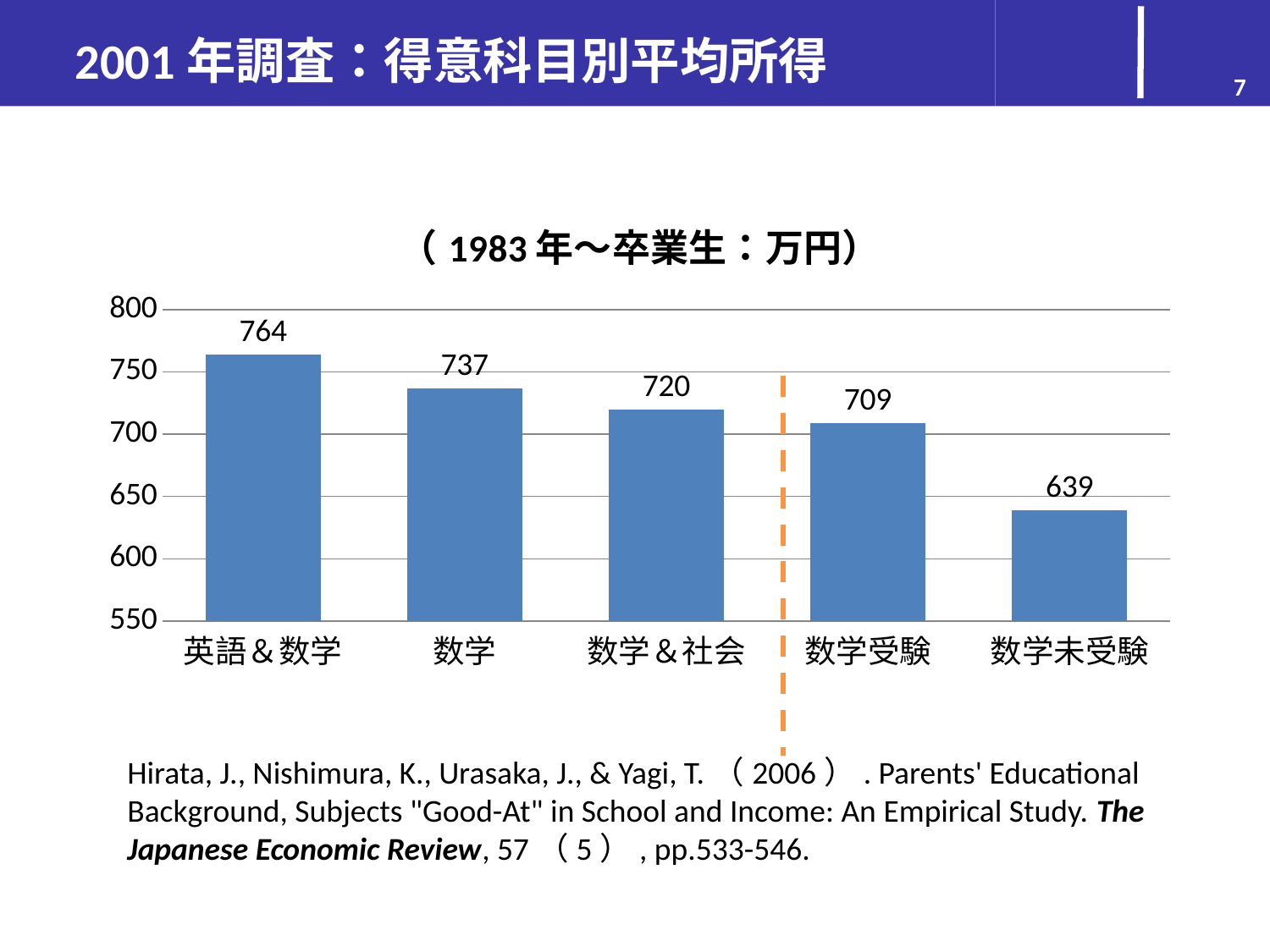
What kind of chart is shown on the slide? bar chart Is the value for 数学受験 greater or less than 700? greater What is the difference between the values for 数学 and 数学受験? 28 What is the difference between the values for 英語＆数学 and 数学未受験? 125 What is the value for 数学未受験? 639 What is the value for 英語＆数学? 764 Which category has the highest value? 英語＆数学 Which is larger, the value for 数学 or the value for 数学＆社会? 数学 Do the values rise or fall from left to right along the x axis? fall Which category has the lowest value? 数学未受験 What is the value for 数学＆社会? 720 How many categories are shown on the x axis? 5